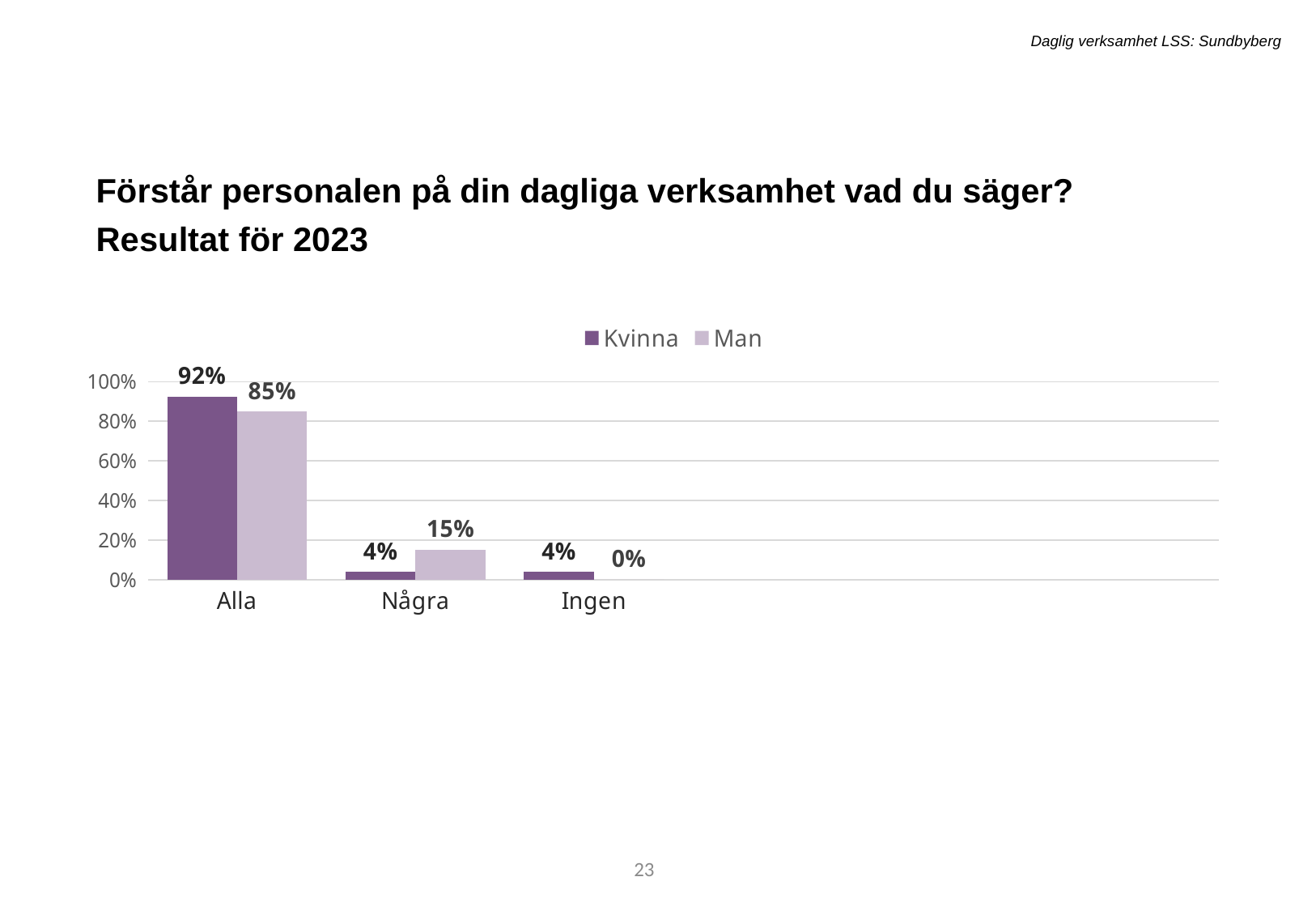
What is the value for Kvinna in the Alla category? 92% Which category has the lowest value for Man? Ingen What is the difference between the Kvinna and Man values in the Alla category? 7% What is the value for Man in the Ingen category? 0% How many categories are shown on the x axis? 3 What kind of chart is shown on the slide? Bar chart What is the value for Man in the Alla category? 85% In the Några category, which series has the larger value, Kvinna or Man? Man Which category has the highest value for Kvinna? Alla Which series is shown in the darker purple colour? Kvinna What is the value for Man in the Några category? 15% How many series does the legend list? 2